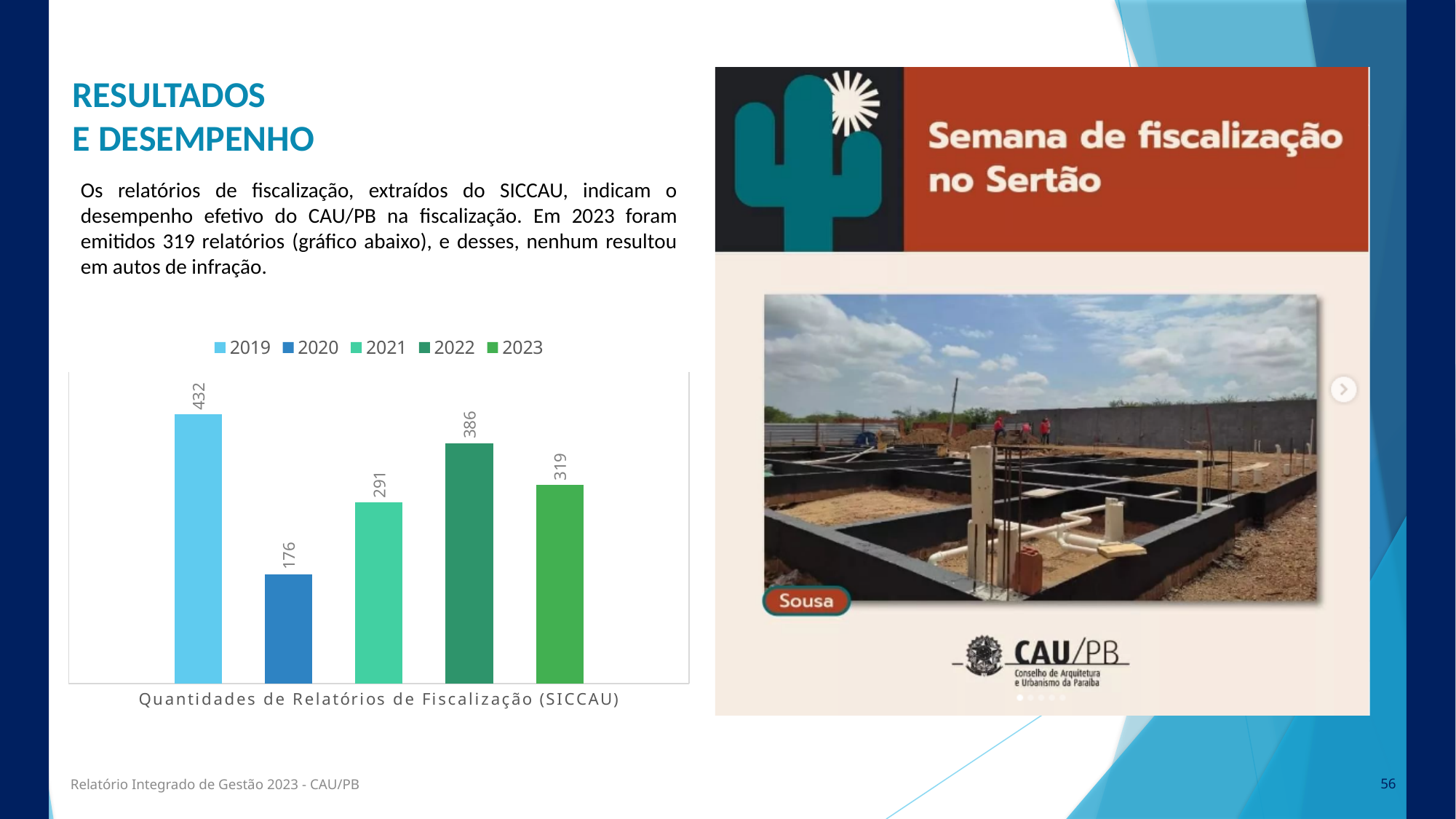
Which year has the highest number of fiscalization reports? 2019 Which year has the lowest number of fiscalization reports? 2020 How many fiscalization reports (SICCAU) were issued in 2019? 432 What is the title shown below the chart? Quantidades de Relatórios de Fiscalização (SICCAU) How many years are shown in the chart? 5 What kind of chart is shown on the slide? Bar chart What is the difference between the values for 2019 and 2020? 256 What is the value shown for 2022 in the chart? 386 Which is larger, the value for 2022 or the value for 2023? 2022 What is the value shown for 2021 in the chart? 291 What is the value shown for 2023 in the chart? 319 What is the value shown for 2020 in the chart? 176